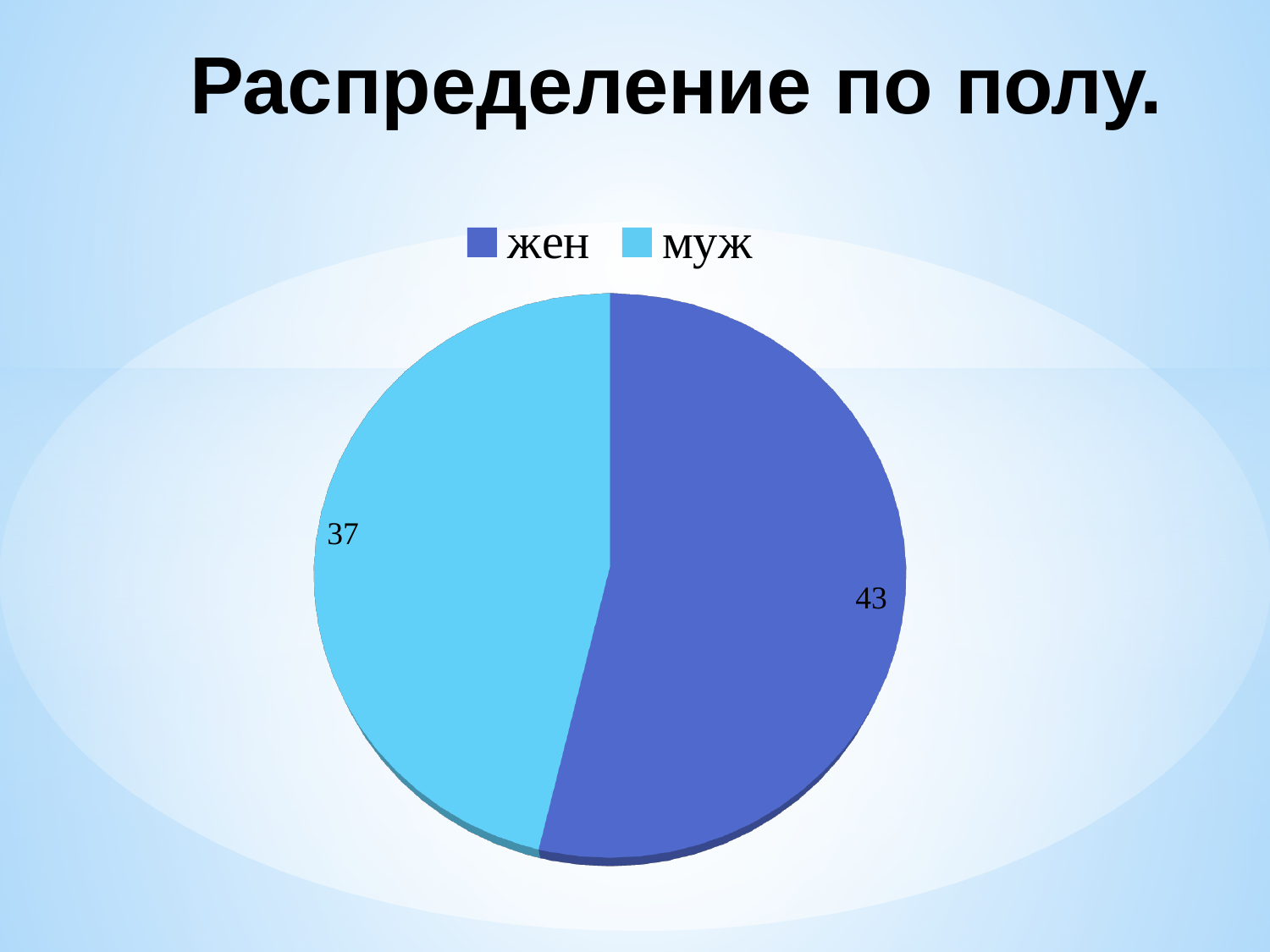
What is the title of the slide? Распределение по полу. What is the value for жен in the pie chart? 43 What is the difference between the values for жен and муж? 6 What is the total of the two slice values in the pie chart? 80 How many entries does the legend list? 2 How many slices does the pie chart have? 2 What is the value for муж in the pie chart? 37 What share of the pie does the жен slice represent? 53.75% What kind of chart is shown on the slide? pie chart Which category has the smallest slice in the pie chart? муж Which category has the largest slice in the pie chart? жен Which is larger, the value for жен or the value for муж? жен